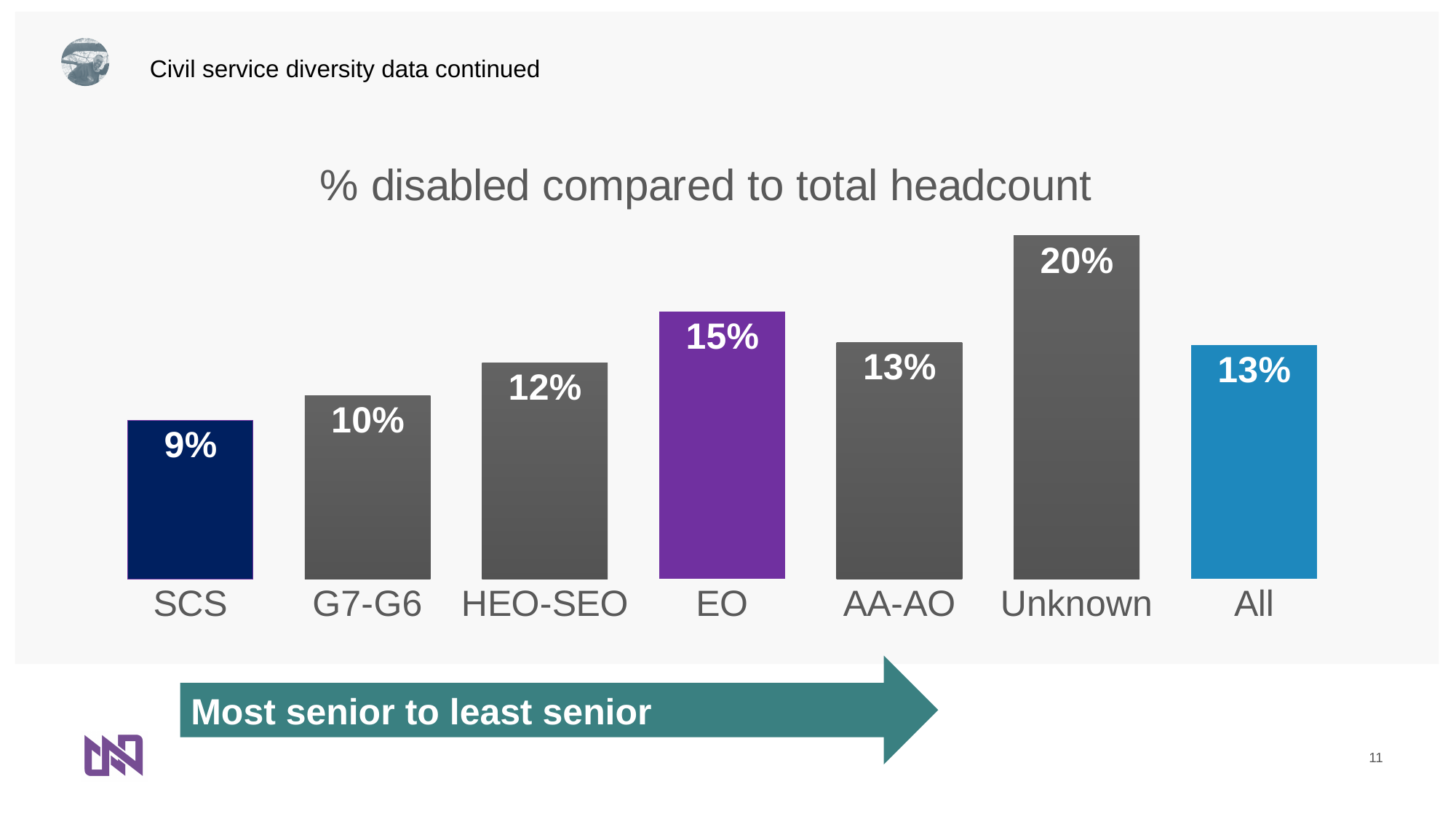
Which is larger, the value for HEO-SEO or the value for AA-AO? AA-AO What is the value for Unknown? 20% What is the difference between the values for EO and G7-G6? 5% What is the value for EO? 15% What is the difference between the values for Unknown and SCS? 11% What is the title of the chart? % disabled compared to total headcount What is the value for SCS? 9% What is the value for All? 13% What kind of chart is this? Bar chart Which category has the lowest value? SCS How many categories are shown on the chart? 7 Which category has the highest value? Unknown